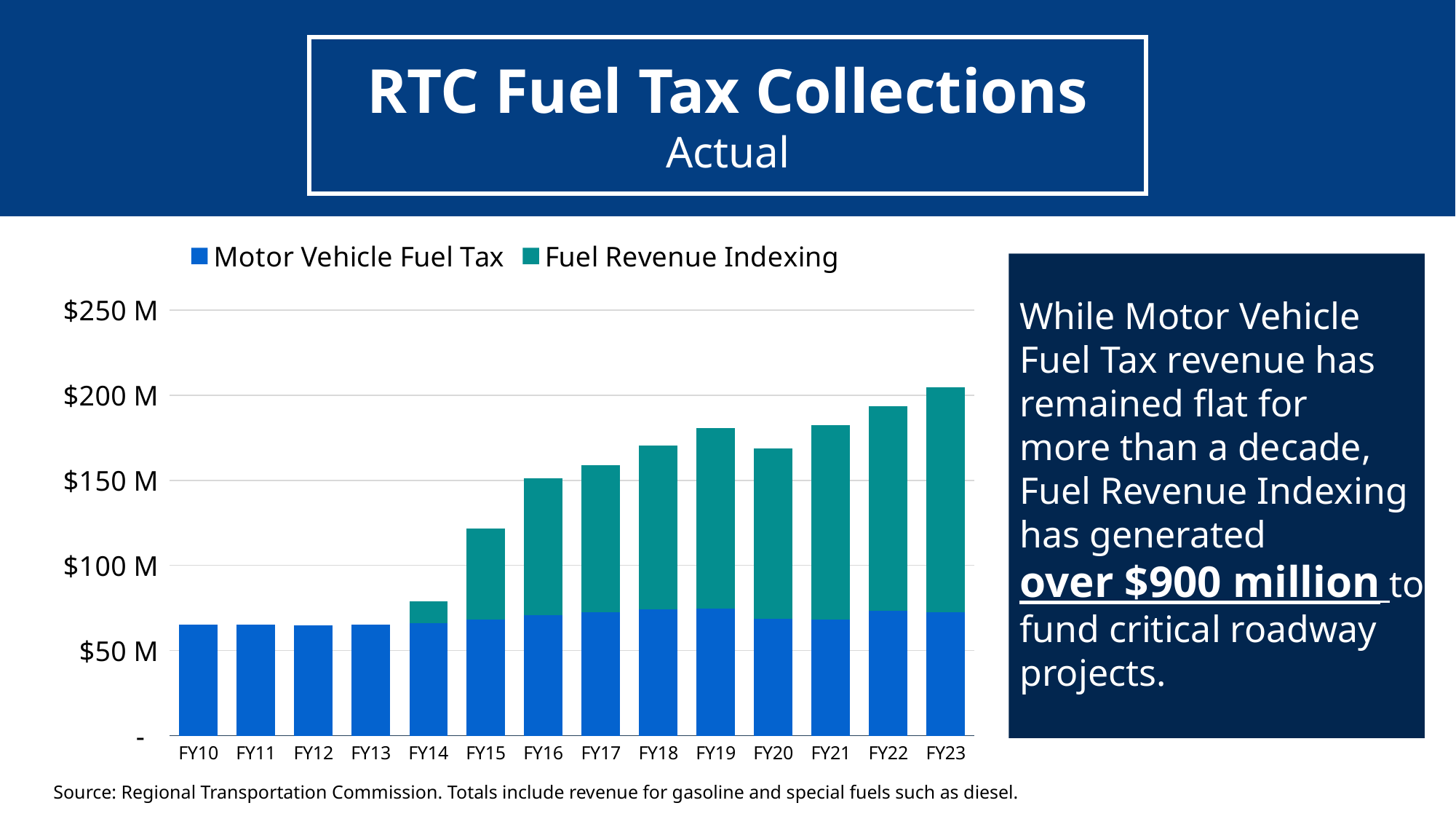
What kind of chart is shown on the slide? stacked bar chart Do total fuel tax collections generally rise or fall from FY10 to FY23? rise How many series does the legend list? 2 Is the total for FY15 greater or less than $100 M? greater Is the total for FY20 greater or less than $200 M? less Which has the larger total, FY19 or FY20? FY19 Is the total for FY23 greater or less than $200 M? greater How many fiscal years are shown on the x axis? 14 What is the title of the chart? RTC Fuel Tax Collections What are the two series named in the legend? Motor Vehicle Fuel Tax and Fuel Revenue Indexing Which fiscal year has the highest total fuel tax collections? FY23